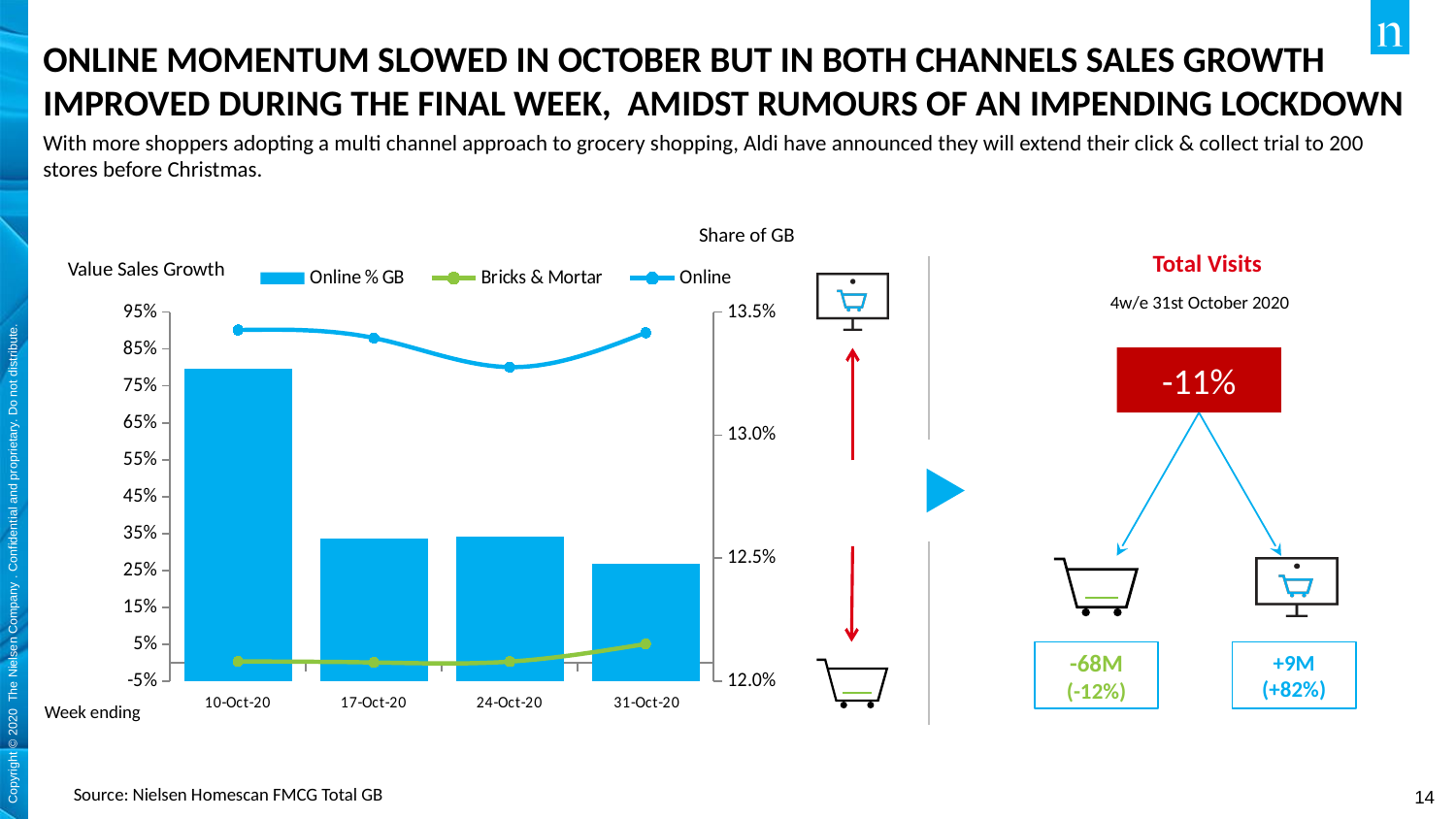
Is the Online % GB value for 31-Oct-20 greater or less than 13.0%? less Is the Online value sales growth for 24-Oct-20 greater or less than 85%? less Which week ending has the highest Online % GB bar? 10-Oct-20 What kind of chart is shown on the slide? Combination bar and line chart Which week ending has the lowest point on the Online line? 24-Oct-20 Do the Online % GB bars rise or fall from 10-Oct-20 to 31-Oct-20? fall Which week ending has the lowest Online % GB bar? 31-Oct-20 Is the Bricks & Mortar value sales growth for 31-Oct-20 greater or less than 15%? less For 10-Oct-20, which series has the higher value sales growth, Online or Bricks & Mortar? Online How many series does the chart's legend list? 3 How many week-ending categories are shown on the x axis of the chart? 4